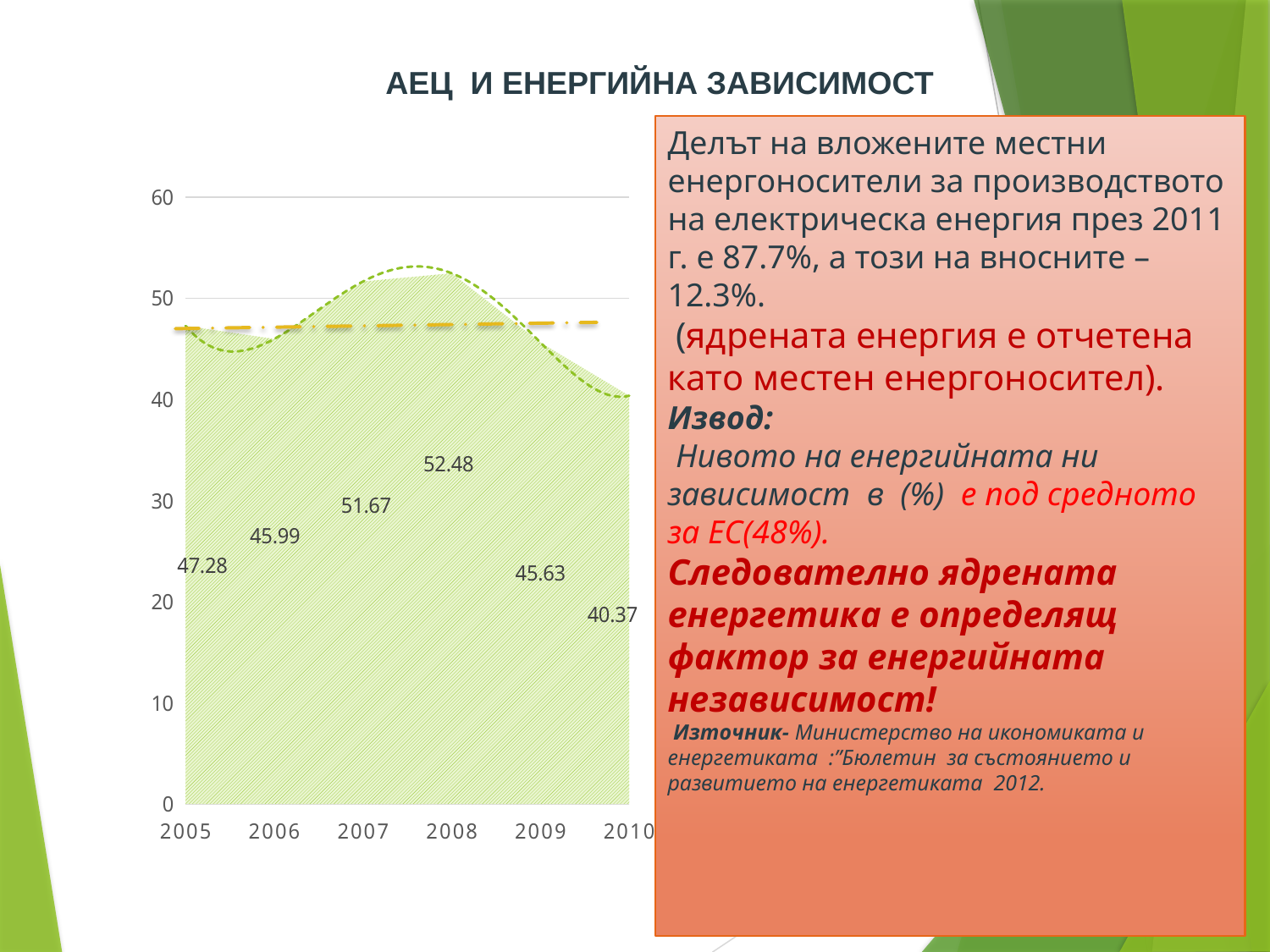
How many years are shown on the x axis? 6 What is the difference between the values for 2008 and 2010? 12.11 Do the values rise or fall from 2008 to 2010? fall What is the value for 2005? 47.28 What is the value for 2010? 40.37 Which year has the lowest value? 2010 What is the value for 2007? 51.67 Is the value for 2009 greater or less than 50? less Which is larger, the value for 2006 or the value for 2009? 2006 Which year has the highest value? 2008 What kind of chart is shown on the slide? area chart What is the value for 2008? 52.48